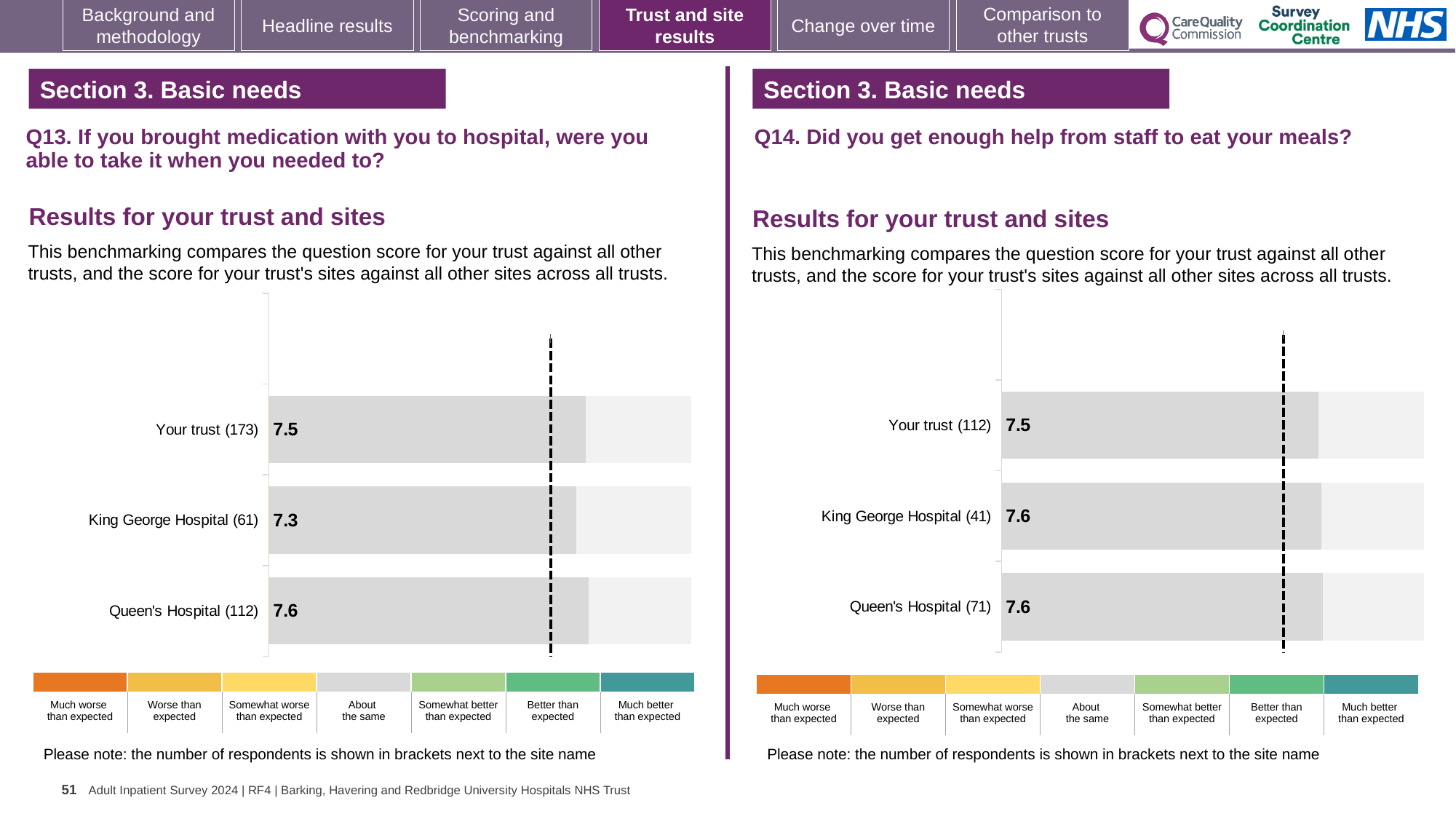
In the Q13 chart on the left, what is the score for Queen's Hospital (112)? 7.6 In the Q13 chart on the left, which site or trust has the highest score? Queen's Hospital (112) What type of chart is used in the Q14 chart on the right? Bar chart In the Q13 chart on the left, which site or trust has the lowest score? King George Hospital (61) In the Q14 chart on the right, what is the score for Queen's Hospital (71)? 7.6 In the Q14 chart on the right, which has the lower score, Your trust (112) or King George Hospital (41)? Your trust (112) How many bars are plotted in the Q13 chart on the left? 3 In the Q13 chart on the left, what is the score for King George Hospital (61)? 7.3 In the Q14 chart on the right, what is the score for Your trust (112)? 7.5 In the Q13 chart on the left, what is the score for Your trust (173)? 7.5 In the Q13 chart on the left, what is the difference between the scores for Queen's Hospital (112) and King George Hospital (61)? 0.3 In the Q14 chart on the right, what is the score for King George Hospital (41)? 7.6